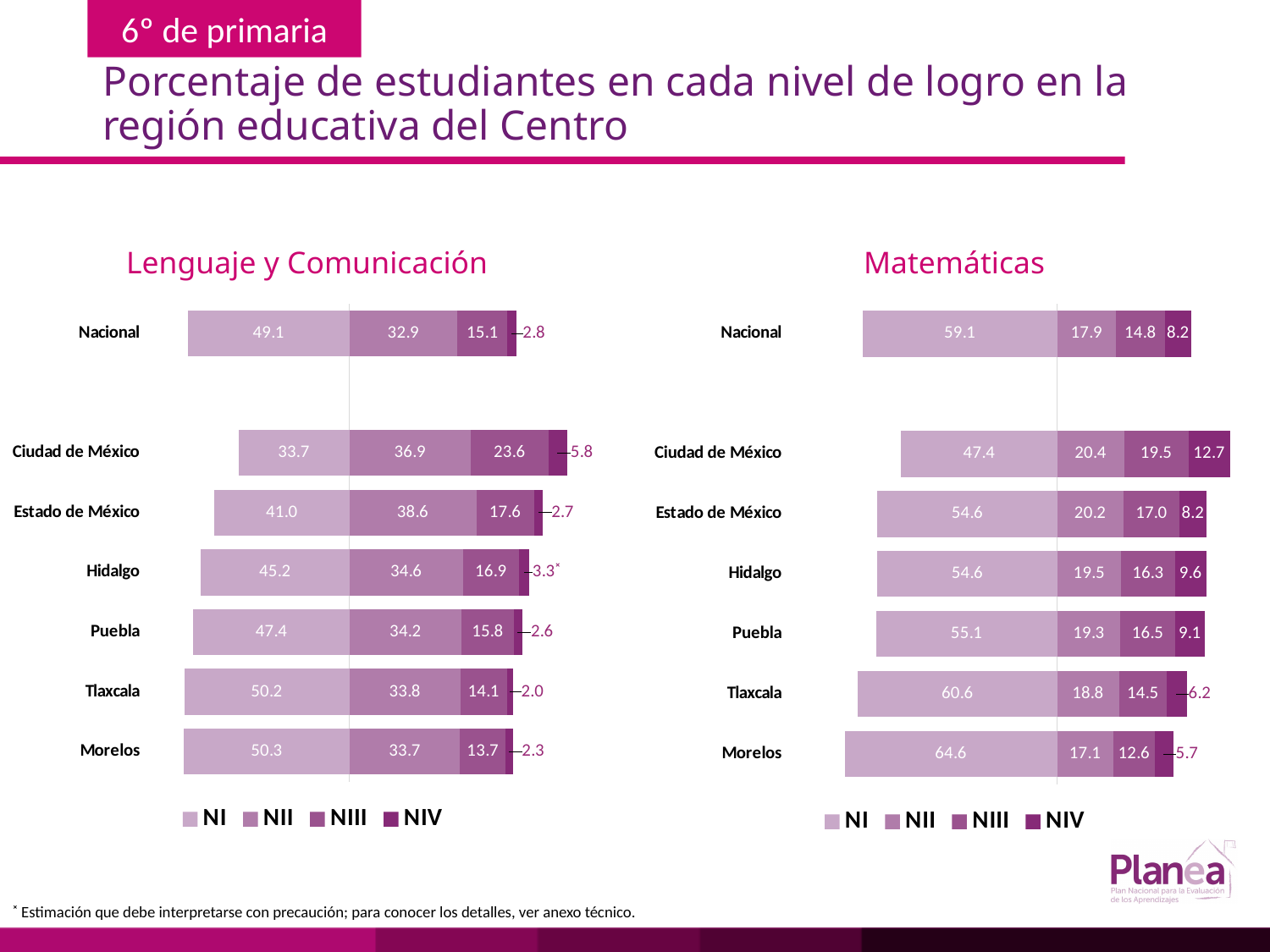
What are the legend entries of the Matemáticas chart? NI, NII, NIII, NIV What kind of chart is the Matemáticas chart? Stacked bar chart In the Lenguaje y Comunicación chart, which category has the lowest NI value? Ciudad de México In the Matemáticas chart, what is the NIV value for Ciudad de México? 12.7 In the Matemáticas chart, what is the NII value for Puebla? 19.3 How many series does the legend of the Lenguaje y Comunicación chart list? 4 In the Lenguaje y Comunicación chart, what is the NI value for Ciudad de México? 33.7 In the Matemáticas chart, which category has the highest NI value? Morelos In the Matemáticas chart, what is the difference between the NIV value for Ciudad de México and the NIV value for Nacional? 4.5 How many categories (rows) are shown in the Matemáticas chart? 7 In the Lenguaje y Comunicación chart, which is larger: the NIII value for Ciudad de México or the NIII value for Morelos? Ciudad de México In the Lenguaje y Comunicación chart, what is the total of the stacked bar for Nacional? 99.9